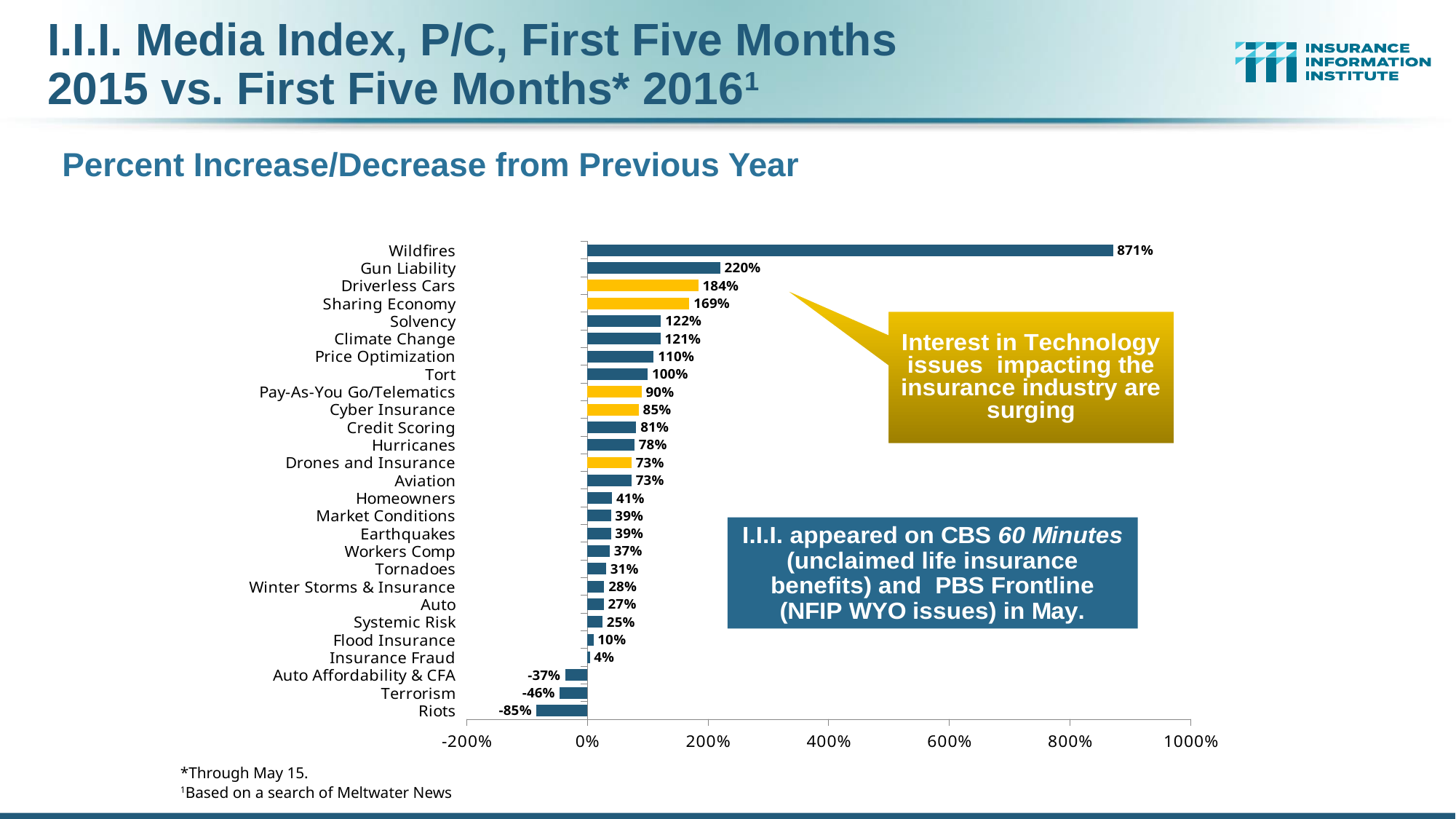
Which has a larger percent change, Solvency or Tort? Solvency What is the percent change shown for Riots? -85% What is the subtitle printed above the chart? Percent Increase/Decrease from Previous Year Which category has the lowest percent change? Riots What is the percent change shown for Terrorism? -46% Is the value for Sharing Economy greater or less than 200%? less What kind of chart is shown on the slide? Bar chart What is the difference between the percent change for Gun Liability and Driverless Cars? 36% What is the percent change shown for Wildfires? 871% How many categories are shown in the chart? 27 Which category has the highest percent change? Wildfires What is the percent change shown for Cyber Insurance? 85%